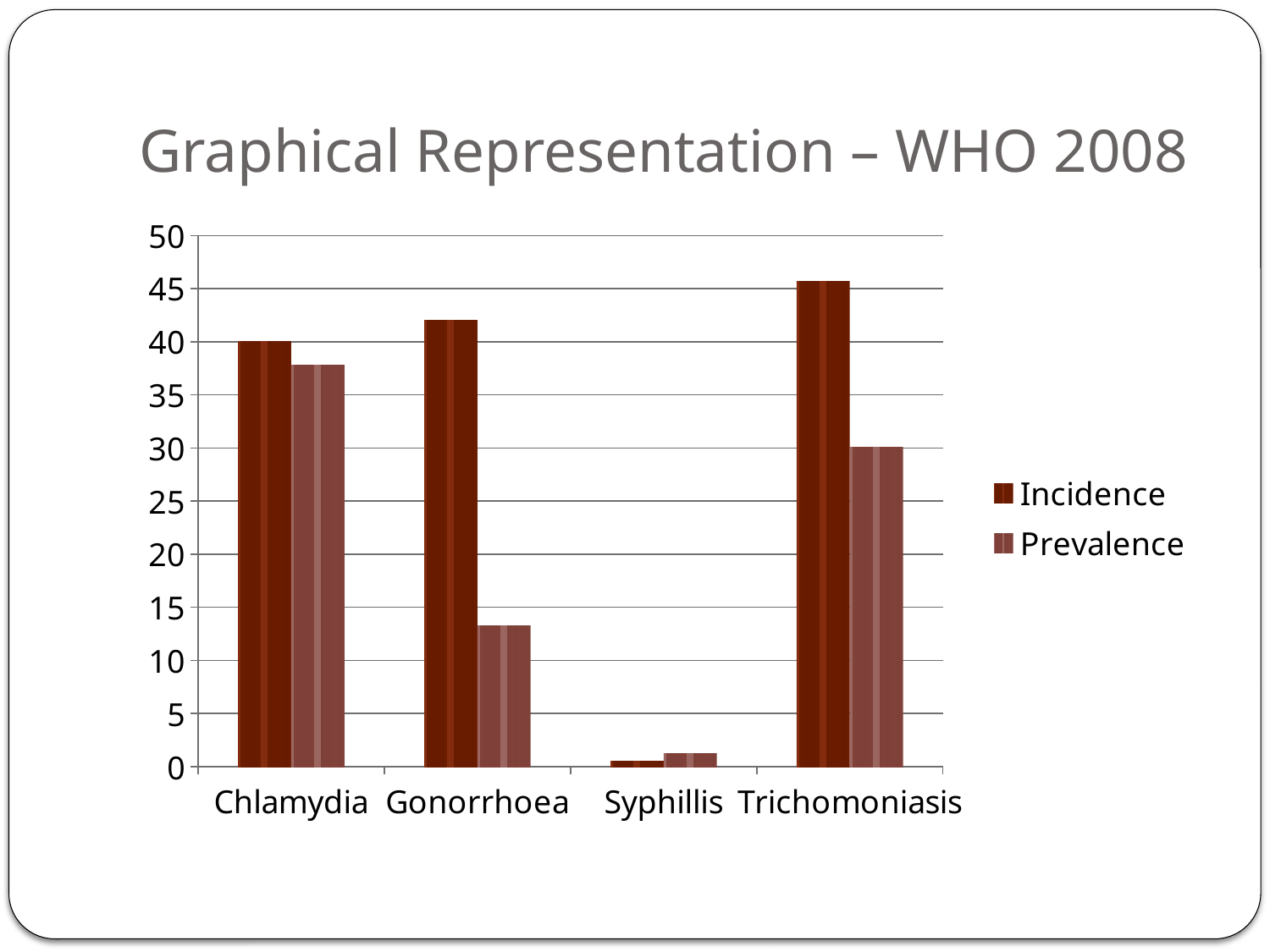
Which category has the highest Prevalence value? Chlamydia Which category has the lowest Incidence value? Syphillis Which category has the highest Incidence value? Trichomoniasis How many series does the legend list? 2 For Gonorrhoea, which is larger: Incidence or Prevalence? Incidence Is the Prevalence value for Gonorrhoea greater or less than 15? less What is the title of the slide containing the chart? Graphical Representation – WHO 2008 Is the Prevalence value for Trichomoniasis greater or less than 25? greater Which category has the lowest Prevalence value? Syphillis How many infection categories are shown on the x axis? 4 What kind of chart is shown on the slide? Bar chart